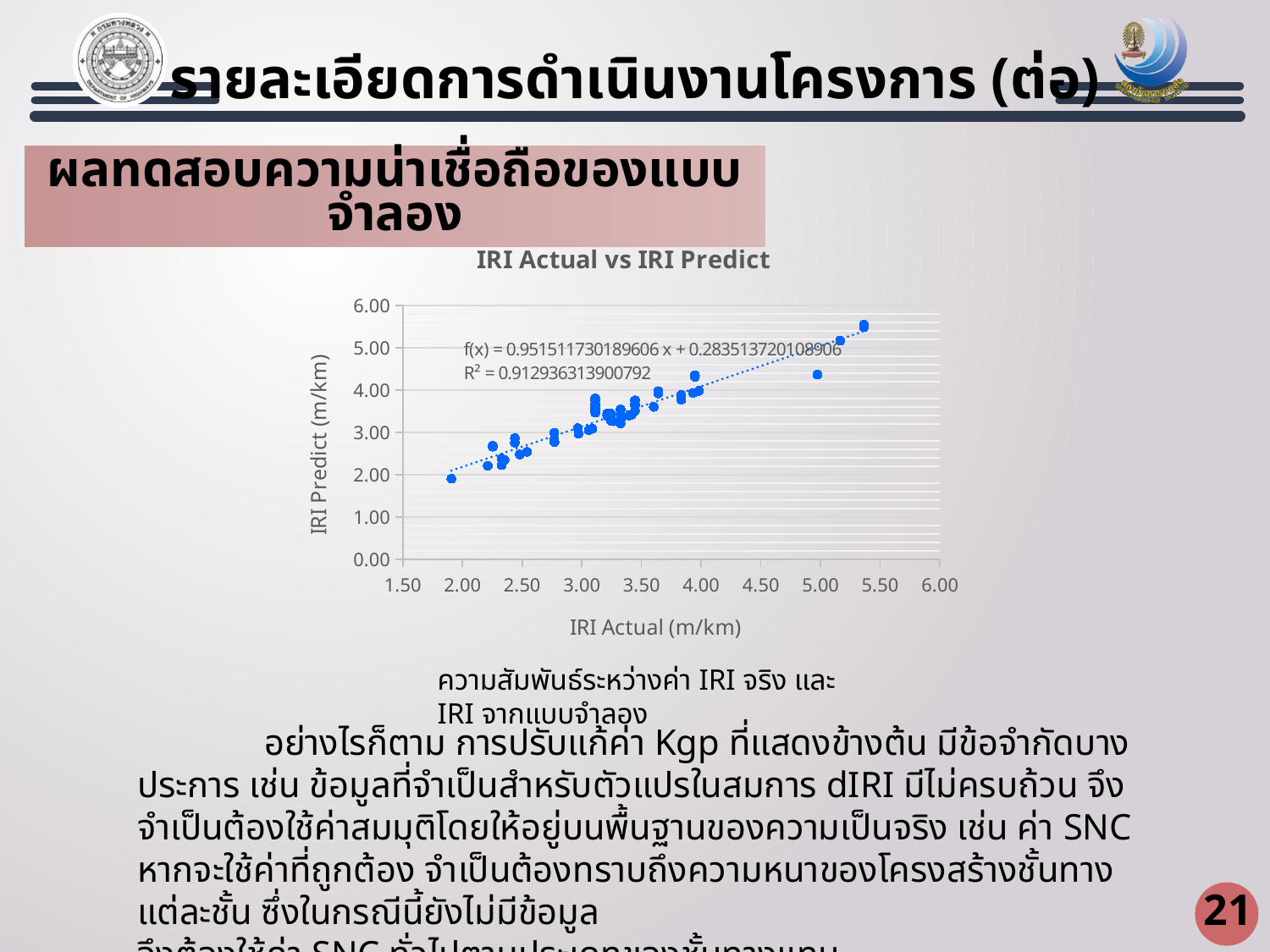
What is the slope of the trendline equation printed on the chart? 0.951511730189606 Is the IRI Predict value of the point with the lowest IRI Actual (around 1.90) greater or less than 3.00? less Is the IRI Predict value of the isolated point at IRI Actual of about 5.00 greater or less than 4.00? greater Is the IRI Predict value of the point with the highest IRI Actual (around 5.40) greater or less than 5.00? greater What is the minimum value shown on the x axis of the chart? 1.50 What is the label of the x axis of the chart? IRI Actual (m/km) What is the intercept of the trendline equation printed on the chart? 0.283513720108906 What R² value is printed on the chart for the trendline? 0.912936313900792 What kind of chart is shown on the slide? scatter chart Do the IRI Predict values generally rise or fall as IRI Actual increases along the x axis? rise What is the title of the chart? IRI Actual vs IRI Predict What is the maximum value shown on the y axis of the chart? 6.00